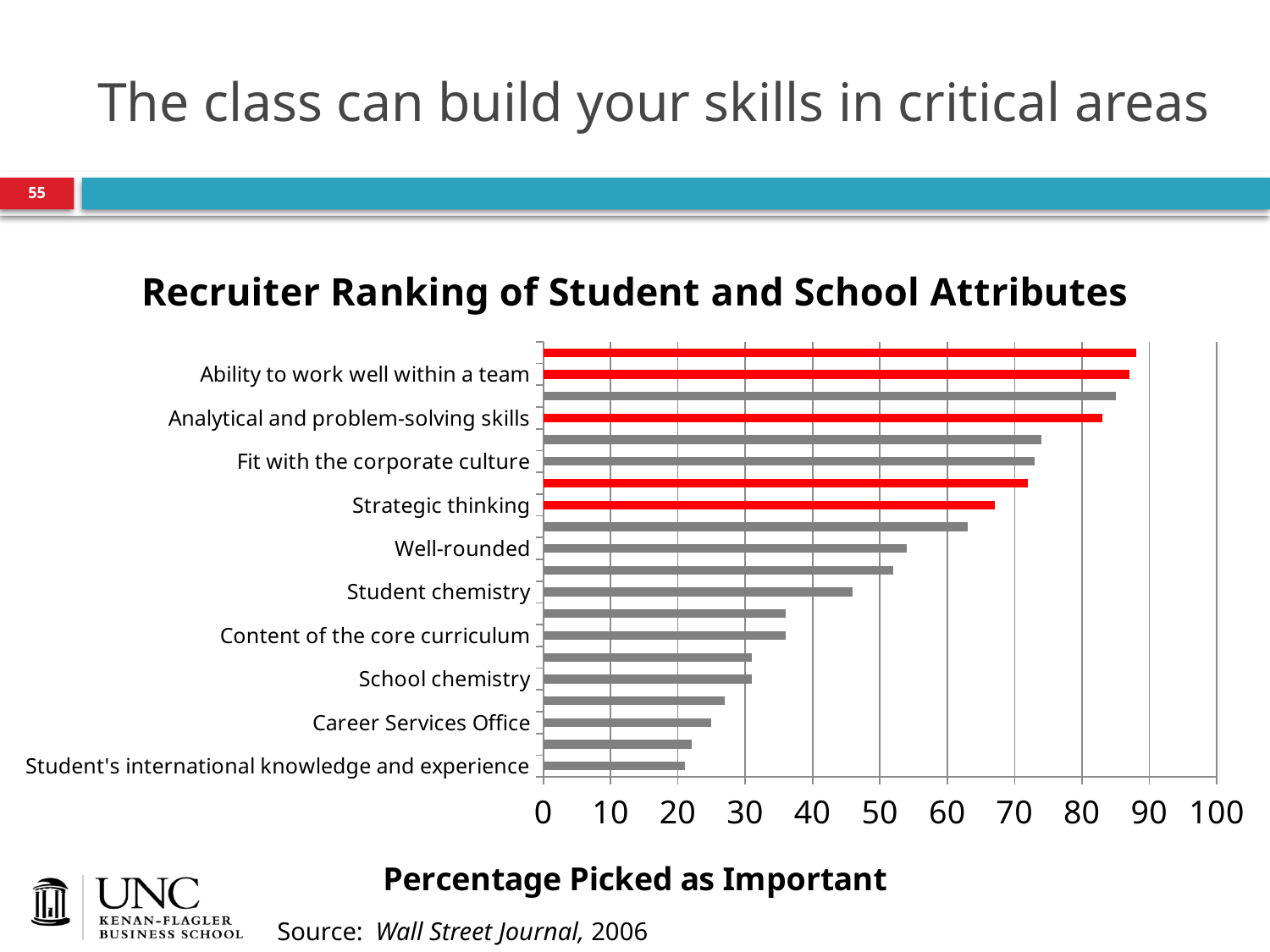
Is the value for Ability to work well within a team greater or less than 80? greater Which has a higher value, Strategic thinking or Well-rounded? Strategic thinking Is the value for Analytical and problem-solving skills greater or less than 80? greater How many bars are plotted in the chart? 20 What is the label of the horizontal axis of the chart? Percentage Picked as Important Is the value for Well-rounded greater or less than 50? greater What is the title of the chart? Recruiter Ranking of Student and School Attributes Which has a higher value, Fit with the corporate culture or Student chemistry? Fit with the corporate culture What kind of chart is shown on the slide? bar chart